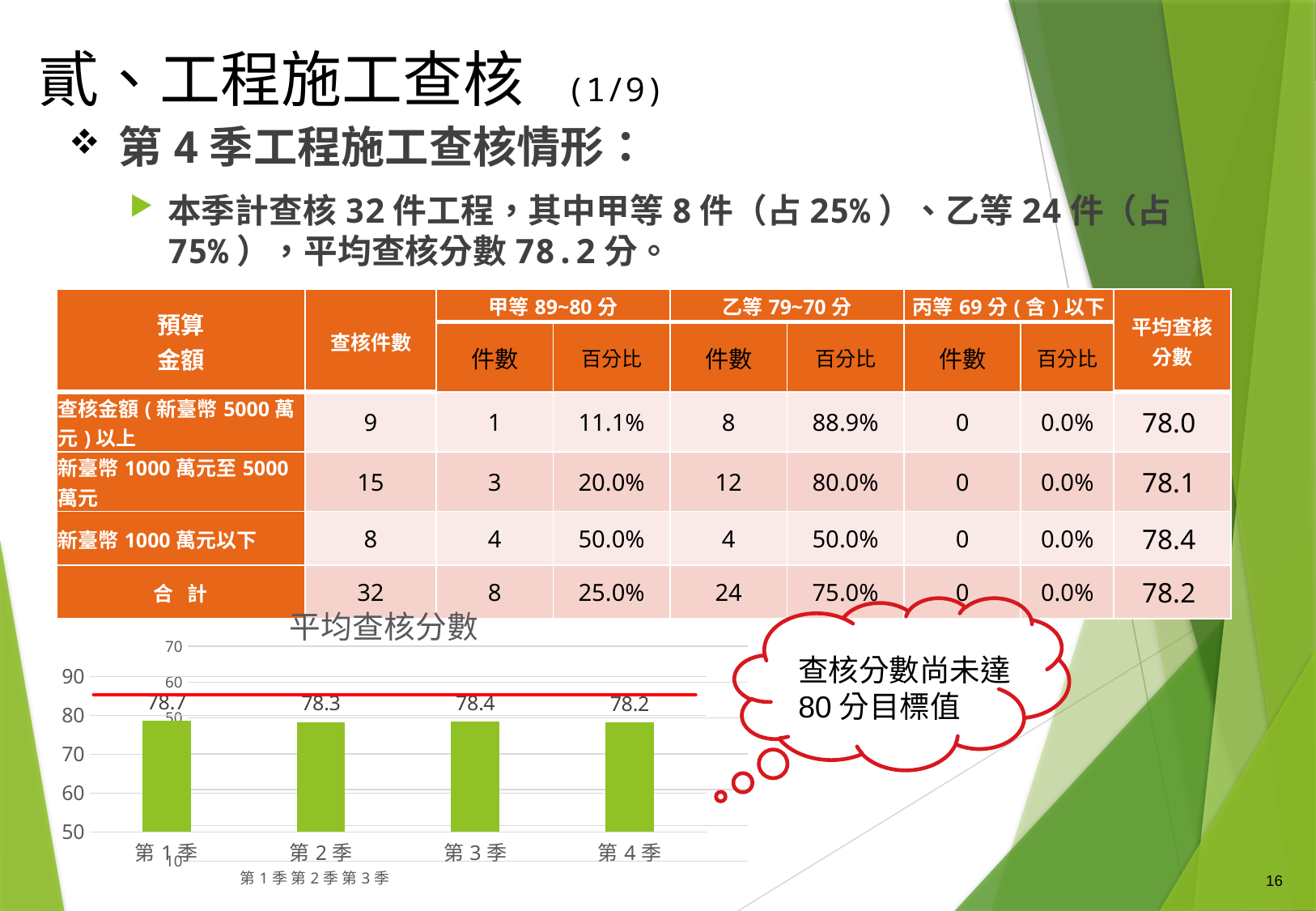
What kind of chart is the 平均查核分數 chart? bar chart In the 平均查核分數 chart, which is larger, the value for 第2季 or 第3季? 第3季 How many quarters are plotted in the 平均查核分數 chart? 4 What is the difference between the values for 第1季 and 第4季 in the 平均查核分數 chart? 0.5 What is the value for 第2季 in the 平均查核分數 chart? 78.3 Which quarter has the lowest value in the 平均查核分數 chart? 第4季 Which quarter has the highest value in the 平均查核分數 chart? 第1季 Is the value for 第4季 in the 平均查核分數 chart greater or less than 80? less What is the value for 第4季 in the 平均查核分數 chart? 78.2 What is the title of the chart on the slide? 平均查核分數 What is the value for 第1季 in the 平均查核分數 chart? 78.7 What is the value for 第3季 in the 平均查核分數 chart? 78.4